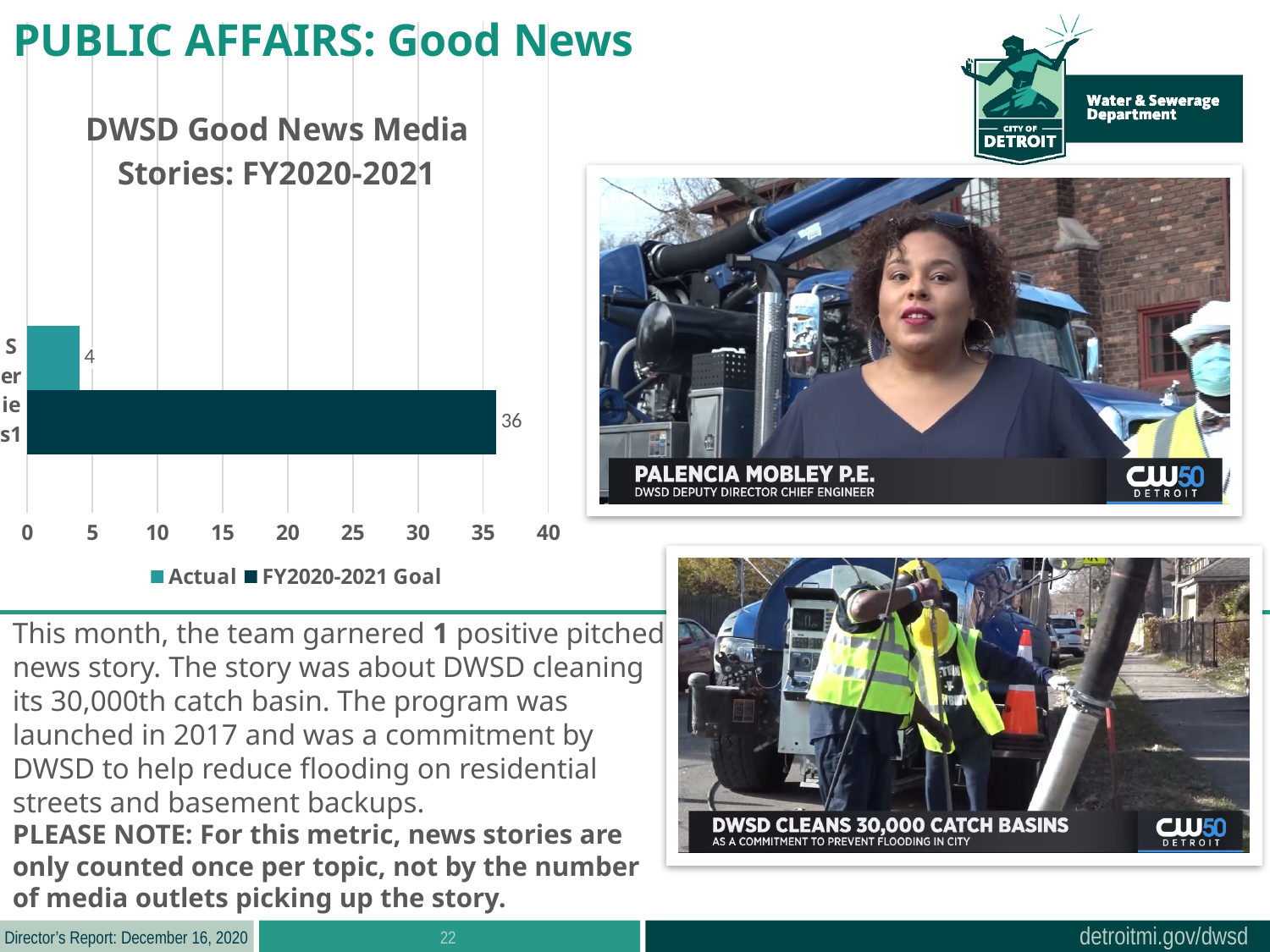
What kind of chart is used to show the DWSD Good News Media Stories? Bar chart What is the title of the chart on the slide? DWSD Good News Media Stories: FY2020-2021 What is the value of the Actual series in the DWSD Good News Media Stories chart? 4 Which series has the highest value in the DWSD Good News Media Stories chart? FY2020-2021 Goal What is the value of the FY2020-2021 Goal series in the DWSD Good News Media Stories chart? 36 How many series does the legend of the DWSD Good News Media Stories chart list? 2 Is the value for Actual greater or less than 5? less Is the value for the FY2020-2021 Goal greater or less than 30? greater Which series has the lowest value in the DWSD Good News Media Stories chart? Actual Which is larger in the chart, the Actual value or the FY2020-2021 Goal? FY2020-2021 Goal What is the highest value shown on the horizontal axis of the chart? 40 What is the difference between the FY2020-2021 Goal and the Actual value in the chart? 32